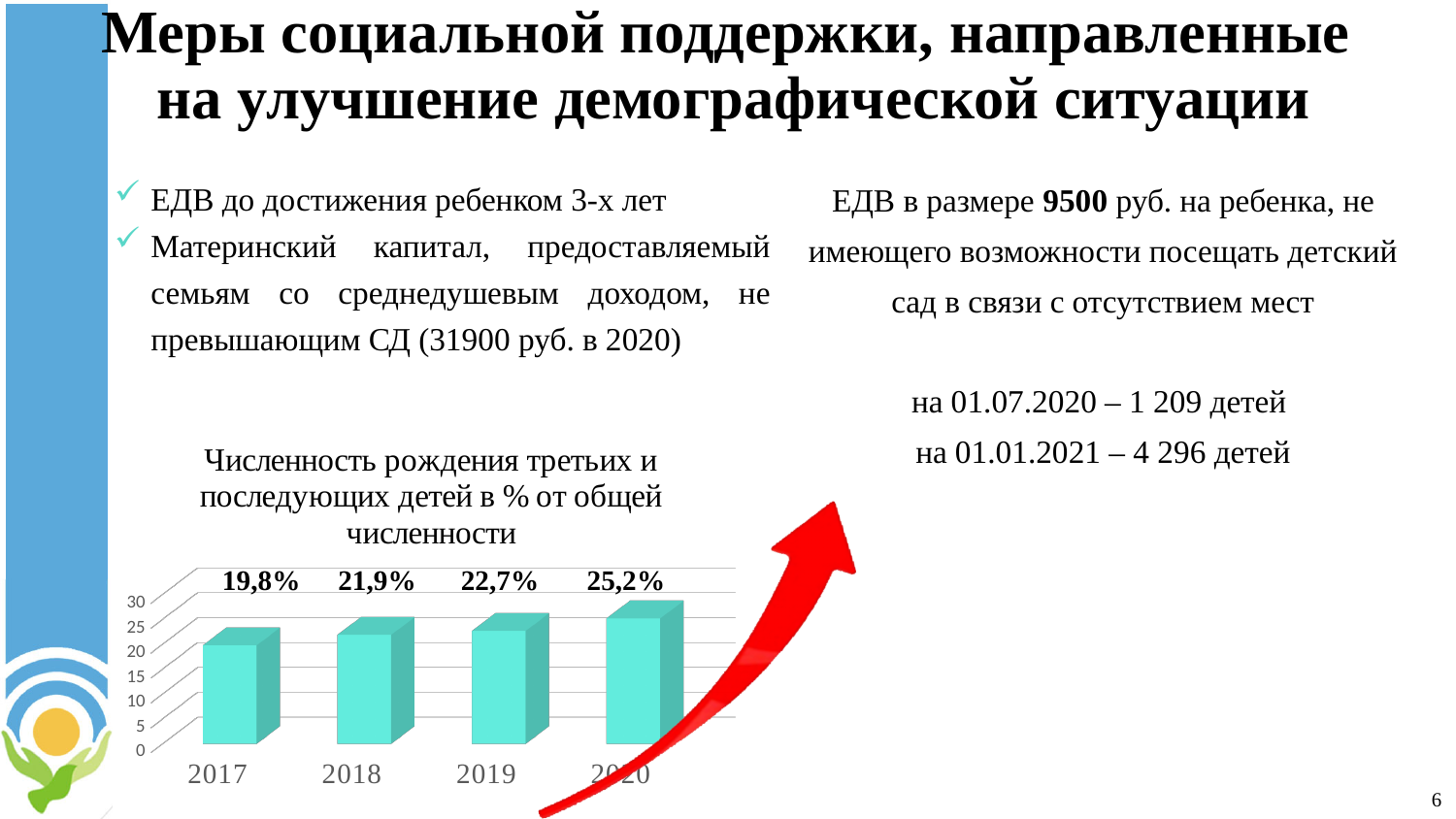
Is the value for 2020 greater or less than 20? greater Which is larger, the value for 2018 or the value for 2019? 2019 Which year has the lowest value? 2017 What is the title of the chart? Численность рождения третьих и последующих детей в % от общей численности What is the difference between the values for 2020 and 2017? 5,4% What kind of chart is shown? bar chart What is the value for 2017? 19,8% What is the value for 2019? 22,7% How many years are shown on the x axis? 4 Do the values rise or fall from 2017 to 2020? rise What is the value for 2020? 25,2% Which year has the highest value? 2020